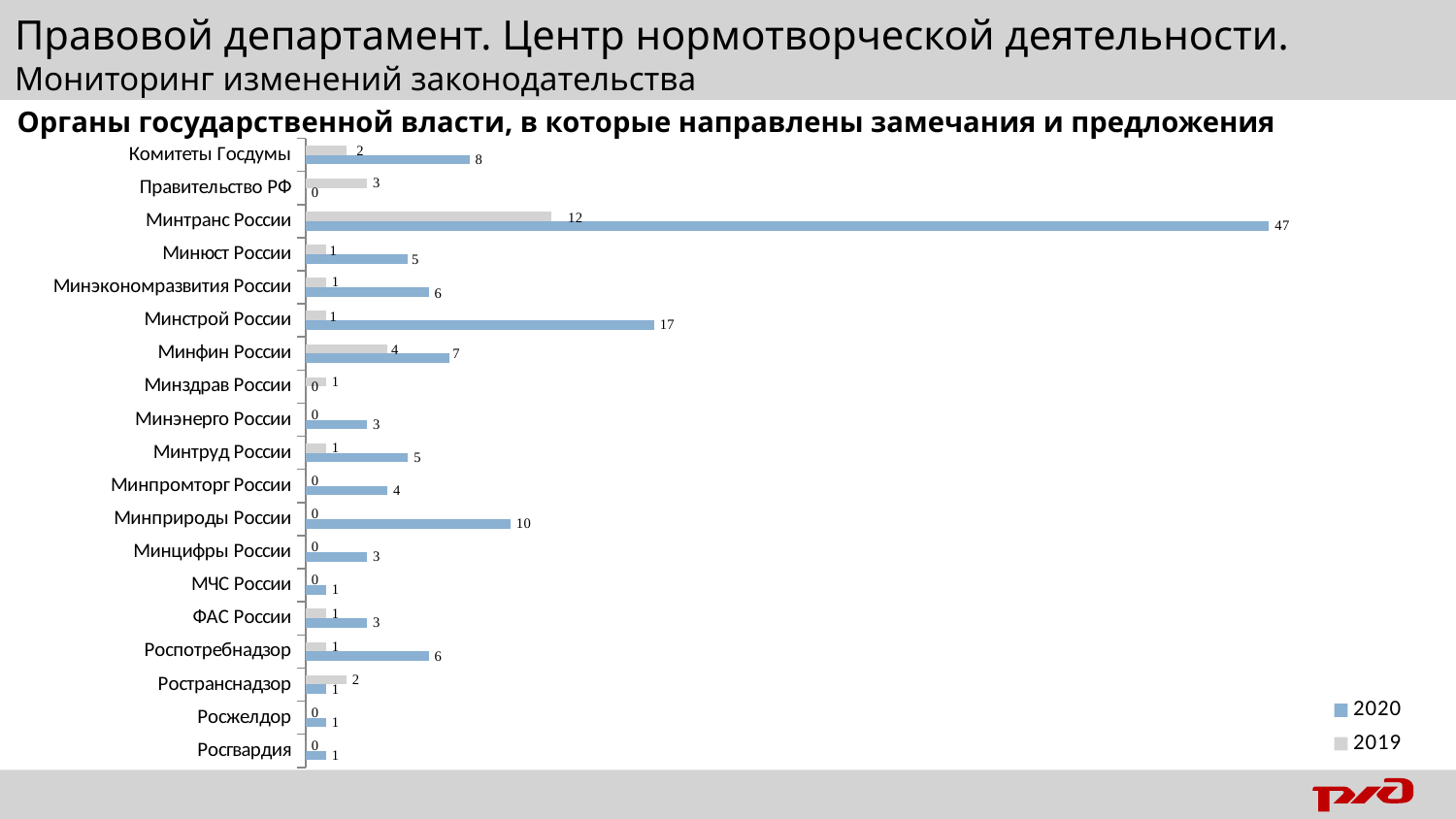
What is the difference between the 2020 values for Минтранс России and Минстрой России? 30 What type of chart is shown on the slide? bar chart Which category has the highest 2020 value? Минтранс России Which is larger for Ространснадзор: the 2019 value or the 2020 value? 2019 How many series does the legend list? 2 What is the difference between the 2020 and 2019 values for Минстрой России? 16 Which colour represents the 2019 series in the legend? gray How many government bodies (categories) are shown in the chart? 19 Which category has the highest 2019 value? Минтранс России What is the 2019 value for Минфин России? 4 What is the 2020 value for Минтранс России? 47 What is the 2020 value for Минприроды России? 10